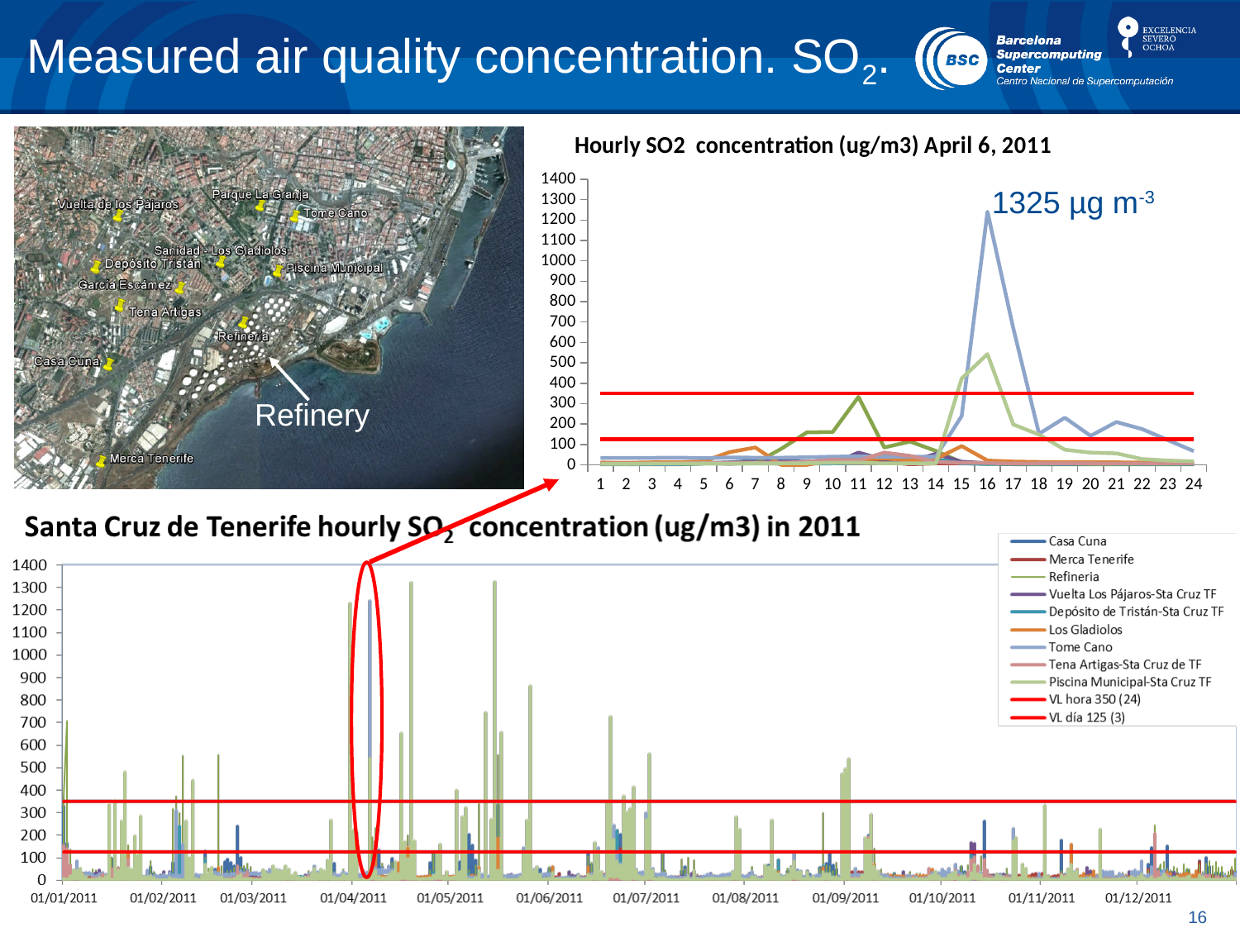
In the chart titled 'Hourly SO2 concentration (ug/m3) April 6, 2011', what peak value is annotated on the chart? 1325 µg m-3 In the chart titled 'Santa Cruz de Tenerife hourly SO2 concentration (ug/m3) in 2011', how many date labels are shown on the x axis? 12 In the chart titled 'Hourly SO2 concentration (ug/m3) April 6, 2011', what is the highest value shown on the y axis? 1400 In the chart titled 'Hourly SO2 concentration (ug/m3) April 6, 2011', is the peak value at hour 16 greater or less than 1000? greater In the chart titled 'Hourly SO2 concentration (ug/m3) April 6, 2011', how many hourly points are shown on the x axis? 24 In the chart titled 'Santa Cruz de Tenerife hourly SO2 concentration (ug/m3) in 2011', how many entries does the legend list? 11 In the chart titled 'Hourly SO2 concentration (ug/m3) April 6, 2011', at which hour does the highest peak occur? 16 In the chart titled 'Santa Cruz de Tenerife hourly SO2 concentration (ug/m3) in 2011', is the circled peak in early April greater or less than 1000? greater In the chart titled 'Hourly SO2 concentration (ug/m3) April 6, 2011', what kind of chart is shown? line chart In the chart titled 'Hourly SO2 concentration (ug/m3) April 6, 2011', are the values at hour 1 greater or less than 100? less What is the title of the chart in the top right of the slide? Hourly SO2 concentration (ug/m3) April 6, 2011 In the chart titled 'Santa Cruz de Tenerife hourly SO2 concentration (ug/m3) in 2011', what is the legend label for the red line drawn at 350? VL hora 350 (24)